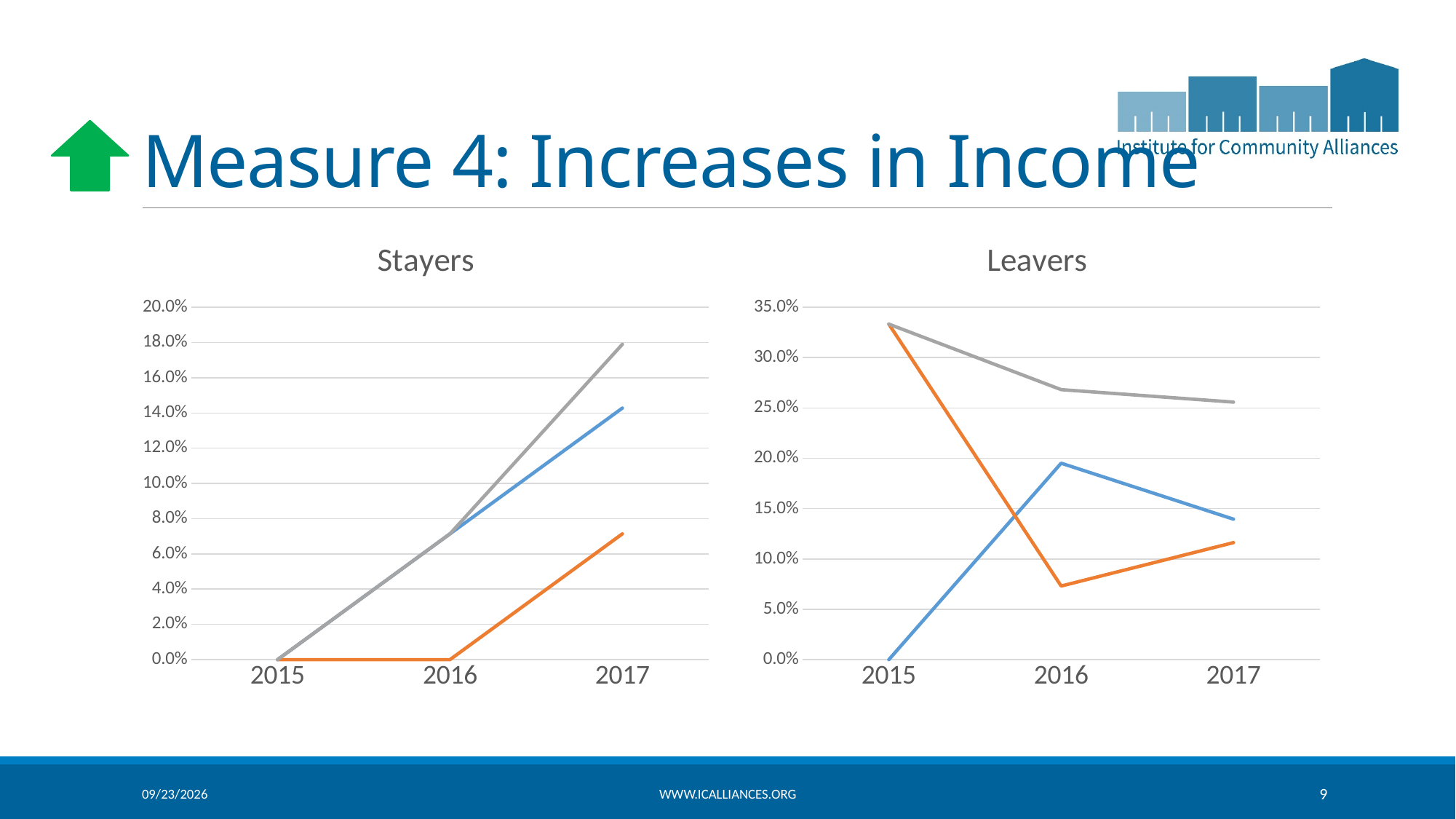
In the Stayers chart, is the value of the gray line in 2017 greater or less than 16.0%? greater How many years are shown on the x axis of the Leavers chart? 3 In the Leavers chart, does the gray line rise or fall from 2015 to 2017? fall In the Stayers chart, what is the value of the orange line in 2016? 0.0% In the Stayers chart, does the gray line rise or fall from 2015 to 2017? rise What kind of chart is the Stayers chart? line chart In the Leavers chart, is the value of the gray line in 2015 greater or less than 30.0%? greater In the Stayers chart, is the value of the blue line in 2017 greater or less than 16.0%? less What is the title of the chart on the right side of the slide? Leavers In the Leavers chart, what is the value of the blue line in 2015? 0.0% In the Leavers chart, which line has the highest value in 2017? gray